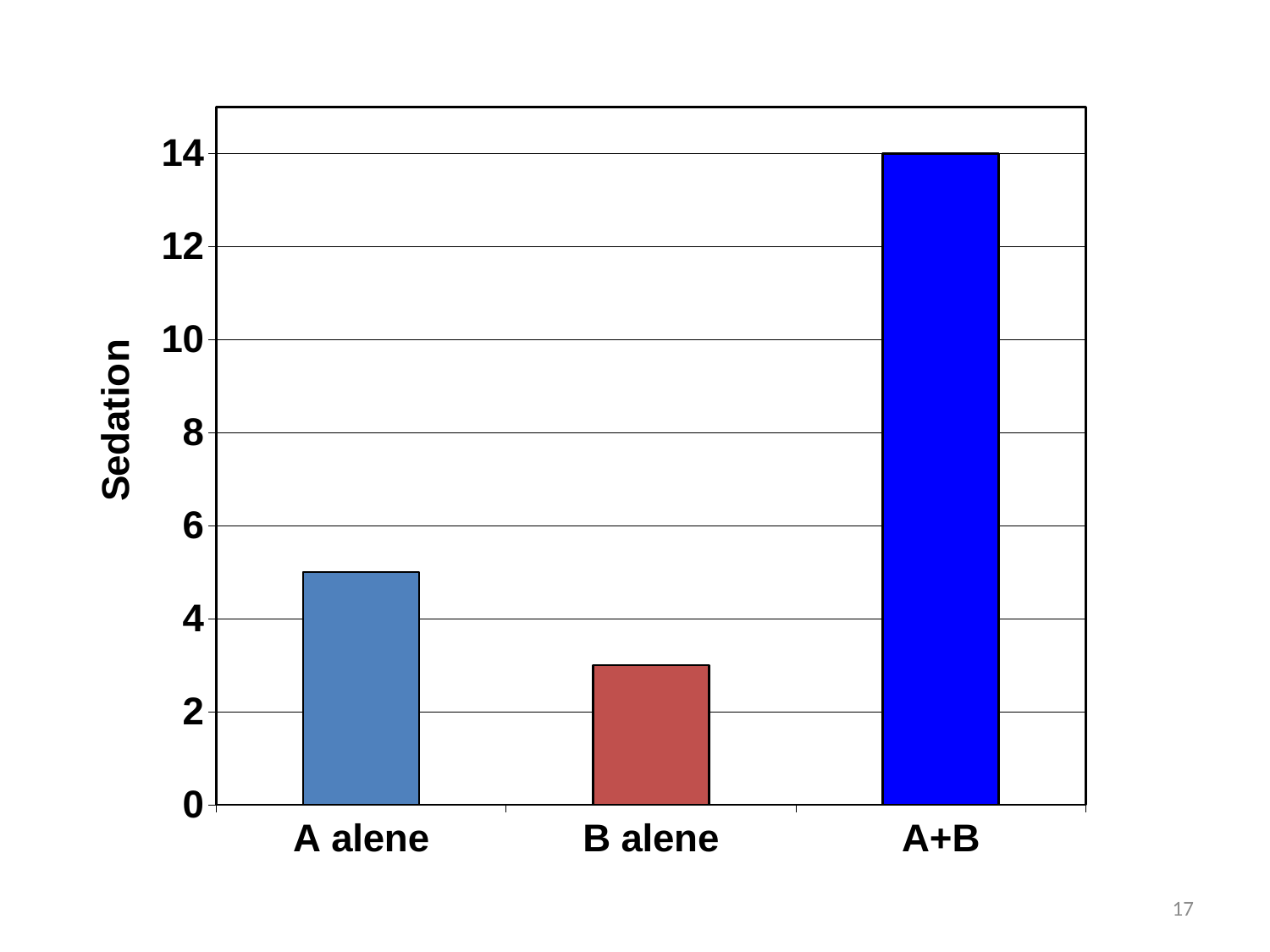
Is the Sedation value for B alene greater or less than 2? greater What is the label of the vertical axis? Sedation Which has a larger Sedation value, A alene or B alene? A alene How many categories are shown on the x axis? 3 What is the Sedation value for A+B? 14 Is the Sedation value for A alene greater or less than 4? greater Is the Sedation value for A alene greater or less than 6? less Which has a larger Sedation value, B alene or A+B? A+B Which category has the highest Sedation value? A+B Which category has the lowest Sedation value? B alene What kind of chart is shown on the slide? Bar chart